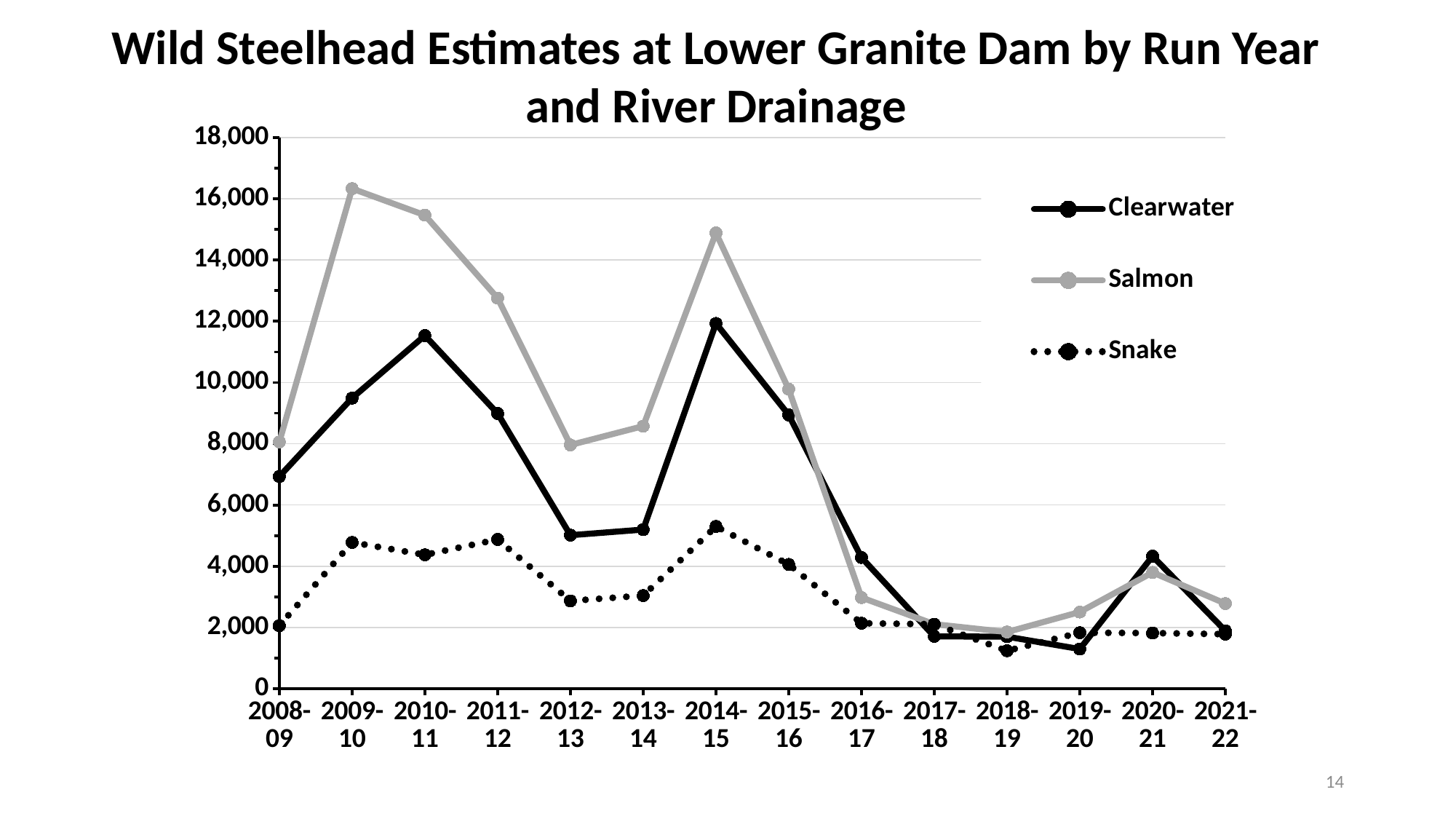
How many series does the legend list? 3 Is the Salmon value for 2009-10 greater or less than 14,000? greater What kind of chart is shown on the slide? line chart In 2009-10, which series has the larger value, Salmon or Clearwater? Salmon Is the Snake value for 2014-15 greater or less than 4,000? greater Is the Salmon value for 2012-13 greater or less than 10,000? less How many run years are plotted along the x axis? 14 Does the Salmon series rise or fall from 2009-10 to 2012-13? fall In which run year does the Salmon series reach its highest value? 2009-10 In 2016-17, which series has the larger value, Clearwater or Salmon? Clearwater In which run year does the Snake series reach its lowest value? 2018-19